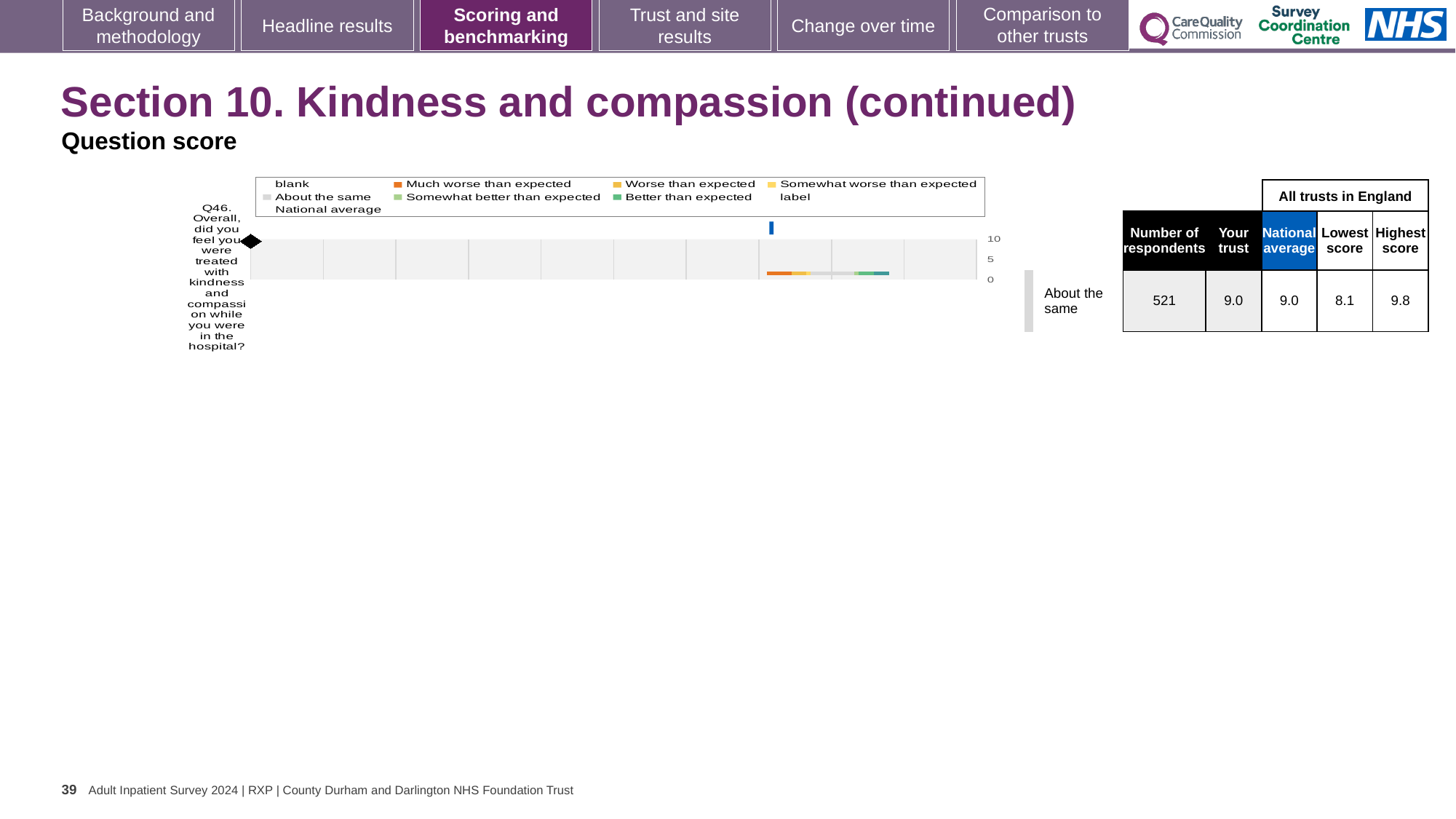
What is the national average score for Q46? 9.0 What is the difference between the highest and lowest scores among all trusts in England for Q46? 1.7 What is the highest value shown on the chart's axis? 10 How many respondents answered Q46? 521 Is the trust's score for Q46 larger than, smaller than, or equal to the national average? equal What question is plotted on the chart? Q46. Overall, did you feel you were treated with kindness and compassion while you were in the hospital? What is the trust's score for Q46? 9.0 What is the lowest score among all trusts in England for Q46? 8.1 How many questions are plotted on the chart? 1 What is the highest score among all trusts in England for Q46? 9.8 Is the trust's score for Q46 greater or less than 5? greater Which benchmark category is the trust's Q46 score placed in? About the same